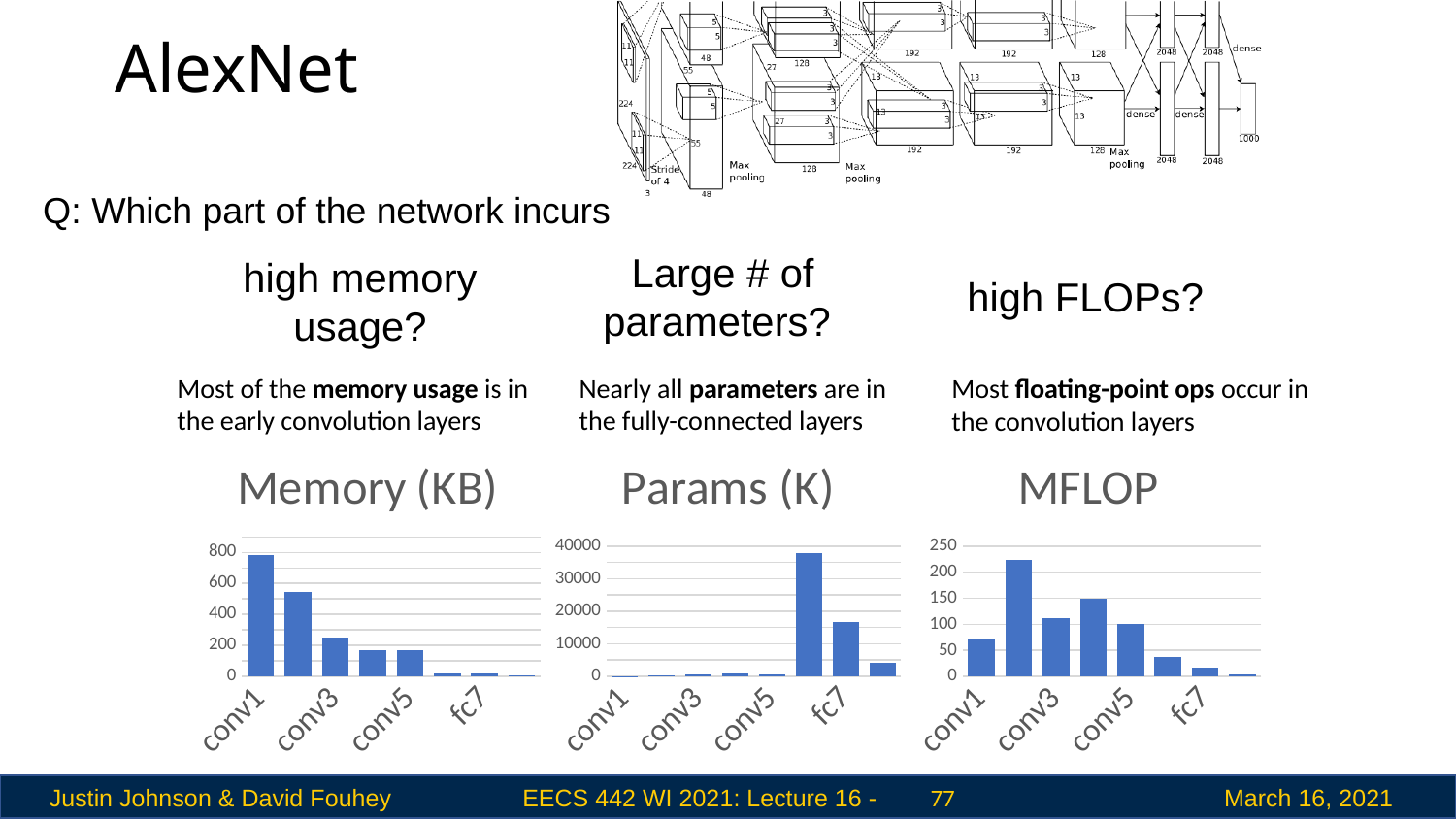
What kind of chart is the MFLOP chart? bar chart In the Memory (KB) chart, is the value for conv5 greater or less than 200? less In the Memory (KB) chart, is the value for conv1 greater or less than 600? greater In the Params (K) chart, is the value for conv1 greater or less than 10000? less In the Memory (KB) chart, which layer has the highest memory usage? conv1 In the Memory (KB) chart, which is larger, the value for conv1 or conv3? conv1 How many bars are plotted in the Params (K) chart? 8